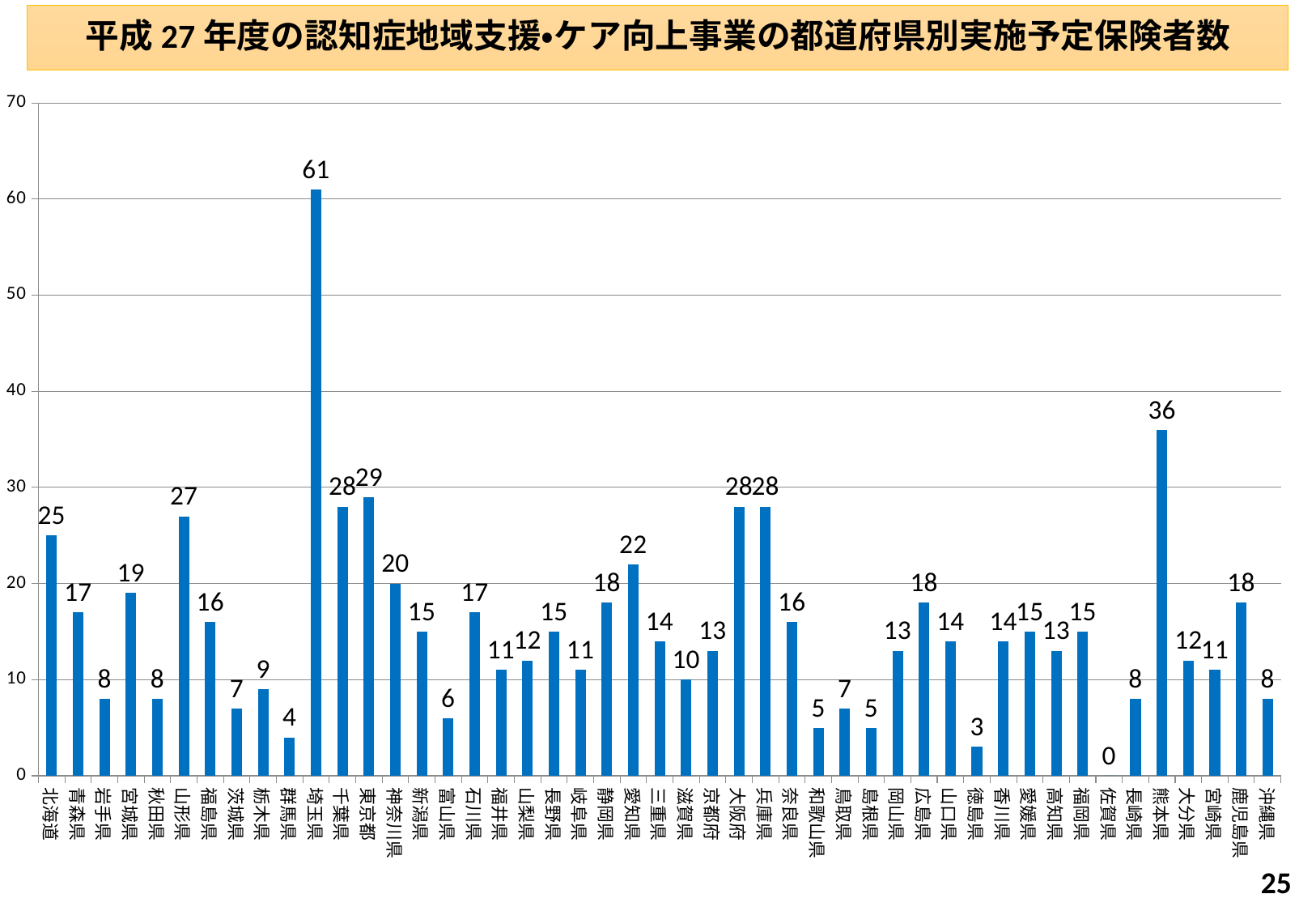
What is the value for 神奈川県? 20 Which prefecture has the lowest value? 佐賀県 What is the value for 熊本県? 36 What is the difference between the values for 東京都 and 千葉県? 1 What is the title of the chart? 平成27年度の認知症地域支援・ケア向上事業の都道府県別実施予定保険者数 Which prefecture has the highest value? 埼玉県 What kind of chart is shown on the slide? bar chart What is the difference between the values for 埼玉県 and 熊本県? 25 How many prefectures are shown on the x axis? 47 Which is larger, the value for 愛知県 or the value for 静岡県? 愛知県 What is the value for 埼玉県? 61 Is the value for 山形県 greater or less than 20? greater